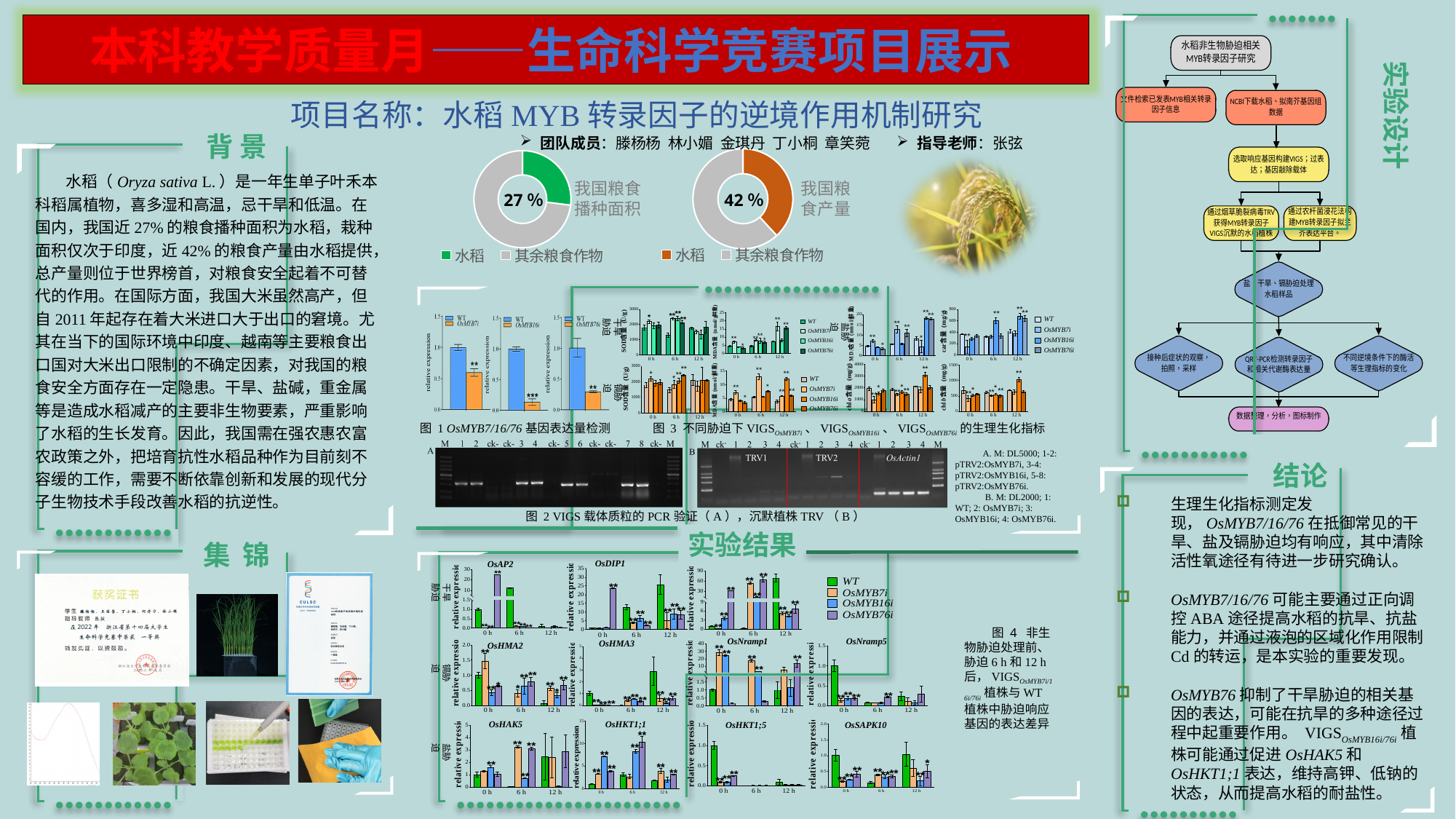
How many series does the legend of the 图 4 bar charts (WT, OsMYB7i, OsMYB16i, OsMYB76i) list? 4 In the 我国粮食产量 donut chart, which slice is the smallest? 水稻 How many entries does the legend of the 我国粮食播种面积 donut chart list? 2 In the 我国粮食播种面积 donut chart, which slice is larger, 水稻 or 其余粮食作物? 其余粮食作物 What colour represents 水稻 in the 我国粮食播种面积 donut chart? Green What kind of chart is used to show 我国粮食播种面积? Donut (pie) chart In the donut chart titled 我国粮食播种面积, what percentage is shown for 水稻? 27 % In the donut chart titled 我国粮食产量, what percentage is shown for 水稻? 42 % What colour represents 水稻 in the 我国粮食产量 donut chart? Orange How many slices does the 我国粮食产量 donut chart have? 2 Is the 水稻 share larger in the 我国粮食播种面积 chart or in the 我国粮食产量 chart? 我国粮食产量